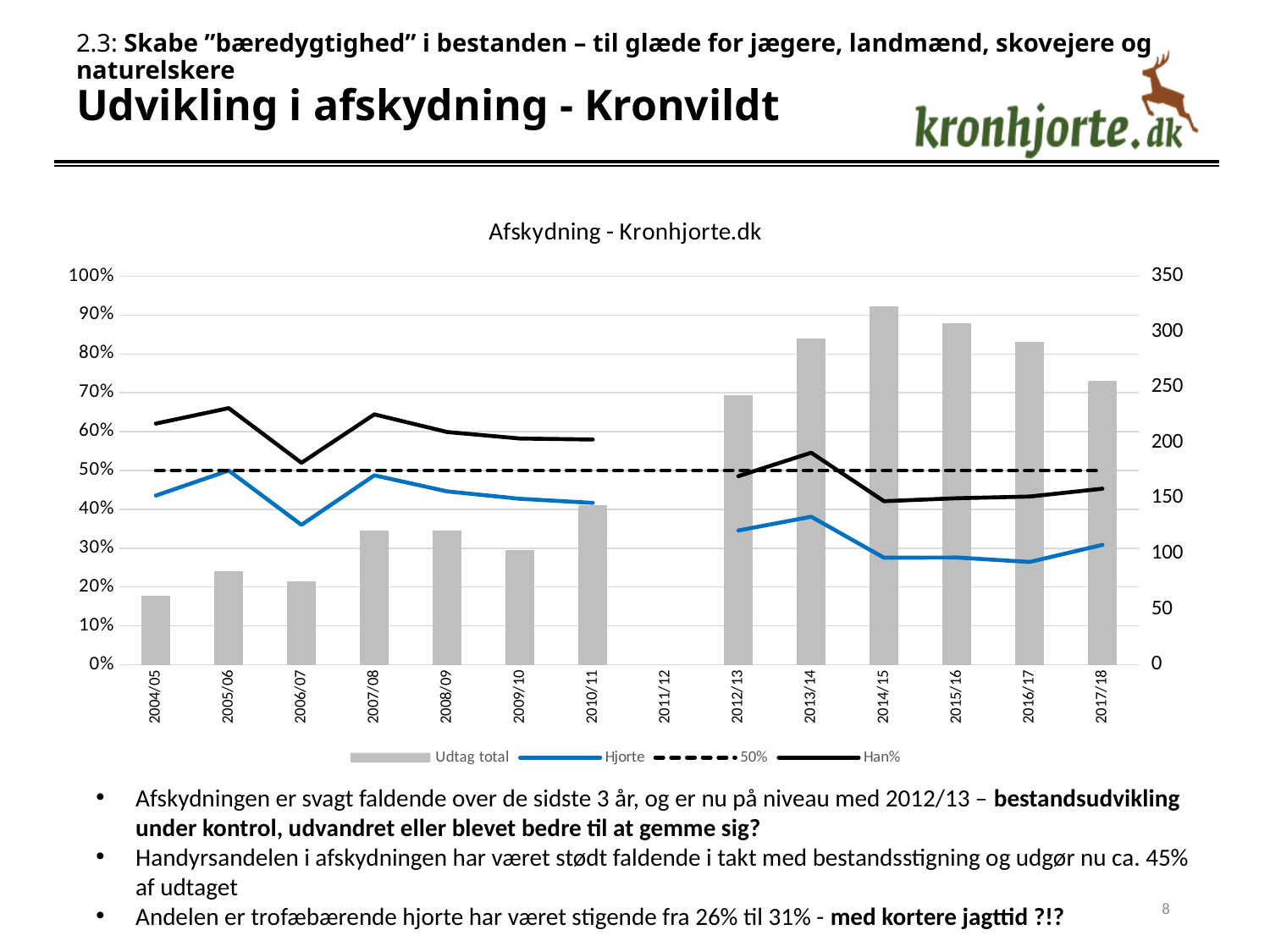
Is the "Udtag total" value for 2013/14 greater or less than 250? greater What kind of chart is "Afskydning - Kronhjorte.dk"? A combination bar and line chart Is the "Udtag total" value for 2014/15 greater or less than 300? greater How many series does the legend of the "Afskydning - Kronhjorte.dk" chart list? 4 What does the dashed black horizontal line in the chart represent, according to the legend? 50% Is the "Han%" value for 2005/06 greater or less than 60%? greater Which season has the larger "Han%" value, 2005/06 or 2006/07? 2005/06 In which season is the "Udtag total" bar highest? 2014/15 How many season categories are shown on the x axis of the "Afskydning - Kronhjorte.dk" chart? 14 Do the "Udtag total" bars rise or fall from 2014/15 to 2017/18? Fall